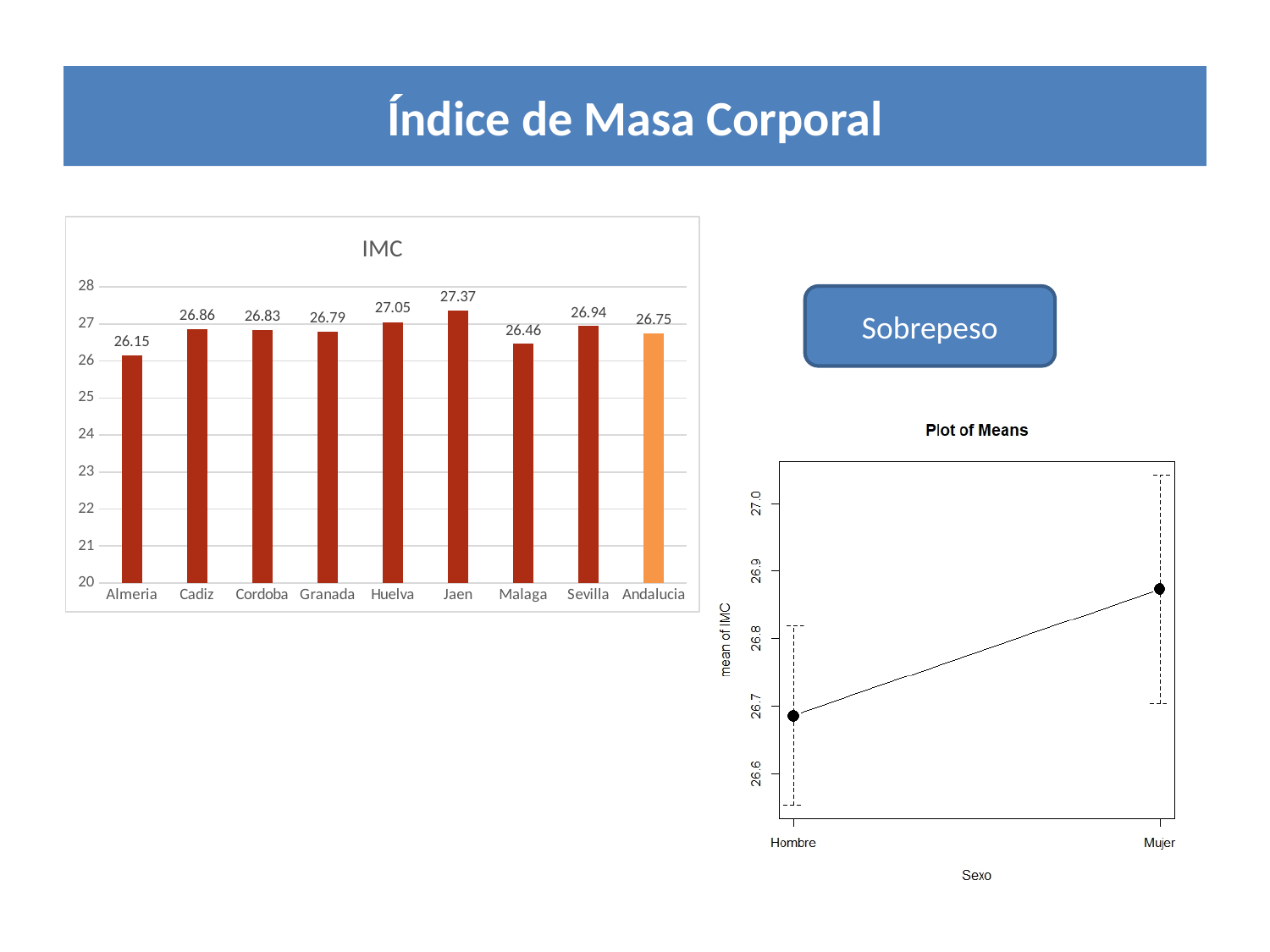
In the IMC chart, what is the difference between the values for Jaen and Almeria? 1.22 In the IMC chart, which bar is shown in a different (lighter orange) colour from the others? Andalucia In the IMC chart, which category has the highest value? Jaen In the IMC chart, what is the value for Jaen? 27.37 In the IMC chart, which is larger, the value for Huelva or the value for Malaga? Huelva In the IMC chart, what is the value for Andalucia? 26.75 In the IMC chart, what is the value for Almeria? 26.15 In the Plot of Means chart, does the mean of IMC rise or fall from Hombre to Mujer? rise In the Plot of Means chart, is the mean of IMC for Mujer greater or less than 26.8? greater How many categories are shown in the IMC chart? 9 In the IMC chart, which category has the lowest value? Almeria What kind of chart is the IMC chart? bar chart